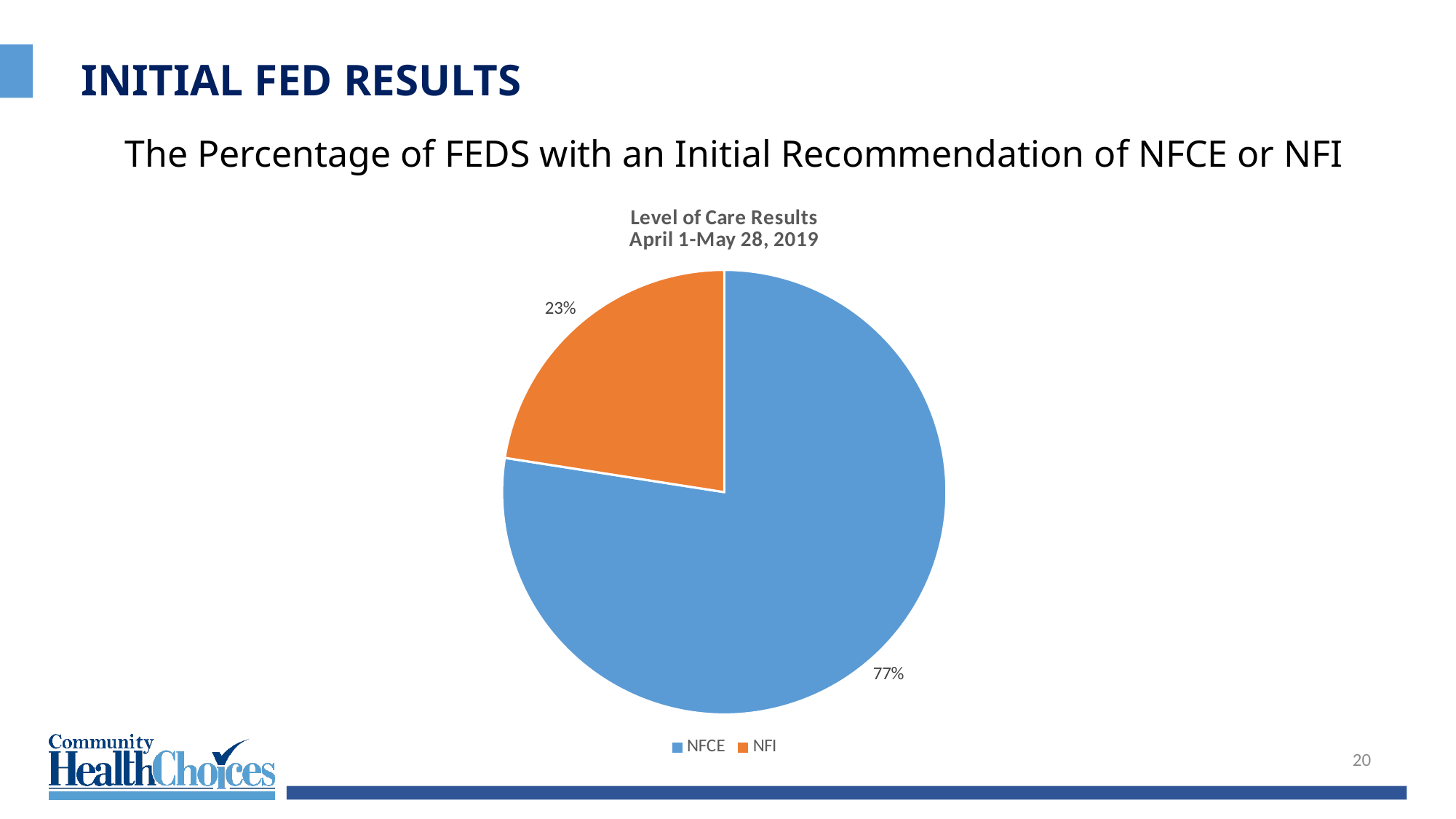
What colour is the NFI slice? orange Which category has the largest share of the pie? NFCE What percentage of the pie is NFCE? 77% Which category has the smallest share of the pie? NFI How many entries does the legend list? 2 What percentage of the pie is NFI? 23% How many slices does the pie chart have? 2 What is the difference in percentage points between the NFCE and NFI slices? 54 Which slice is larger, NFCE or NFI? NFCE What type of chart is shown on the slide? pie chart What is the share of the pie for NFCE? 77% What is the title of the chart? Level of Care Results April 1-May 28, 2019